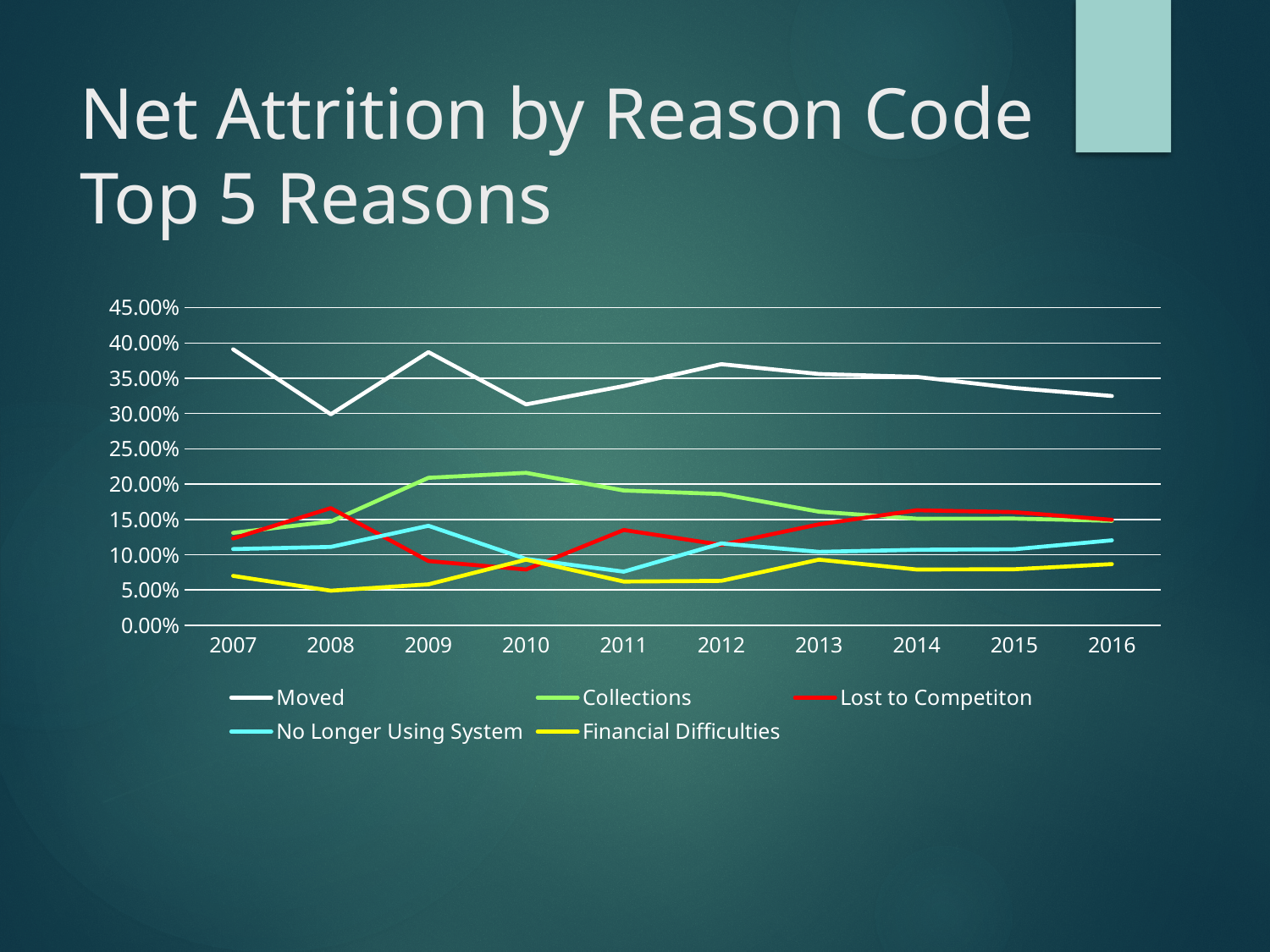
Is the value for Moved in 2012 greater or less than 35.00%? greater What kind of chart is shown on the slide? line chart Is the value for Collections in 2010 greater or less than 20.00%? greater How many years are plotted along the x axis? 10 Which reason code has the lowest net attrition in 2008? Financial Difficulties Is the value for Moved in 2008 greater or less than 35.00%? less Which reason code has the highest net attrition in 2016? Moved How many series does the legend list? 5 Does the Collections line rise or fall from 2010 to 2016? fall In 2009, which is larger: Collections or Lost to Competiton? Collections In 2009, which is larger: No Longer Using System or Financial Difficulties? No Longer Using System